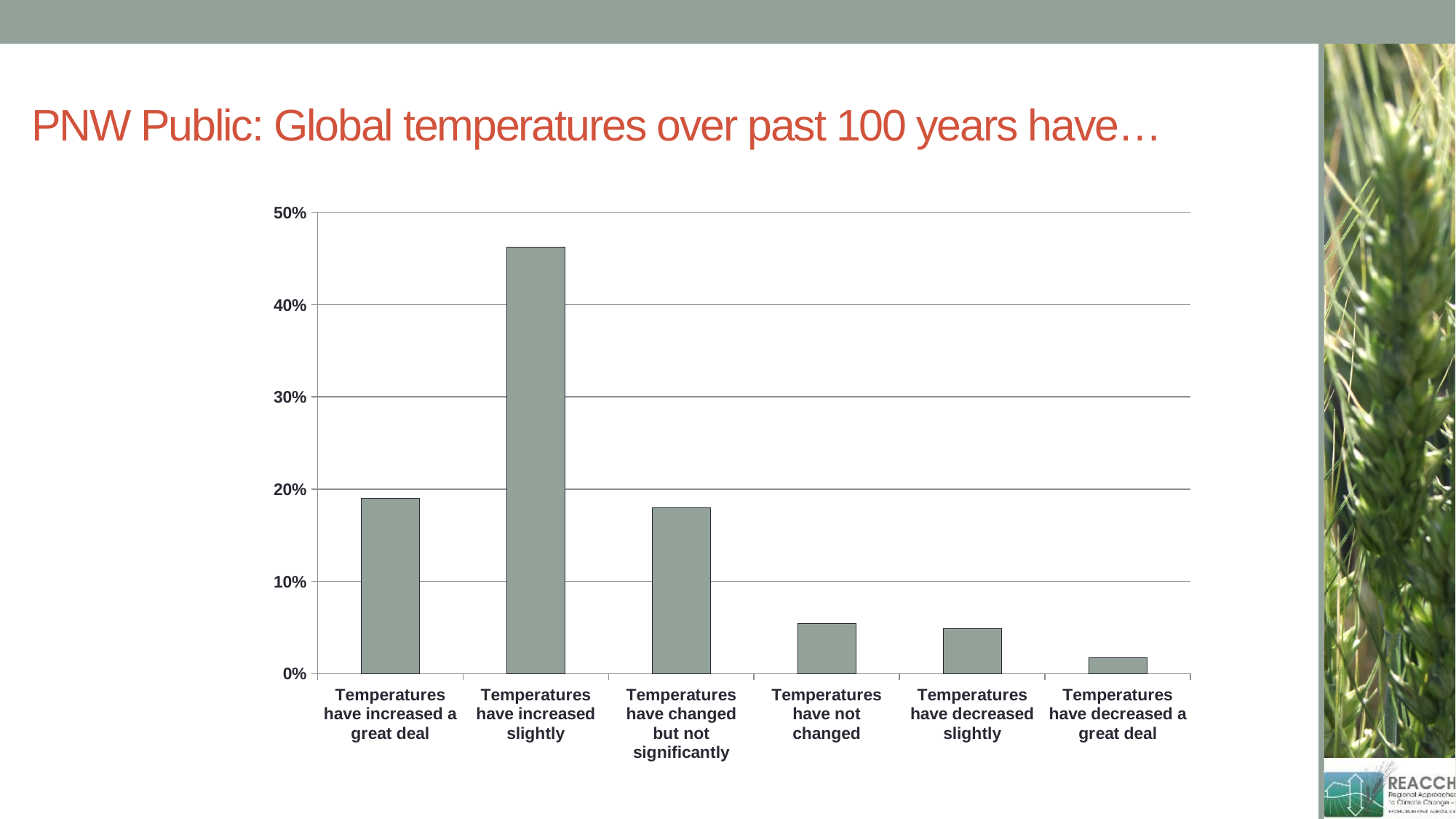
Which category has the highest value in the chart? Temperatures have increased slightly Which is larger: the value for "Temperatures have increased slightly" or the value for "Temperatures have increased a great deal"? Temperatures have increased slightly What kind of chart is shown on the slide? Bar chart Which category has the lowest value in the chart? Temperatures have decreased a great deal What is the title of the slide containing the chart? PNW Public: Global temperatures over past 100 years have… Which is larger: the value for "Temperatures have decreased slightly" or the value for "Temperatures have decreased a great deal"? Temperatures have decreased slightly Is the value for "Temperatures have not changed" greater or less than 10%? less Is the value for "Temperatures have decreased a great deal" greater or less than 10%? less Is the value for "Temperatures have increased slightly" greater or less than 40%? greater How many categories are shown on the x axis of the chart? 6